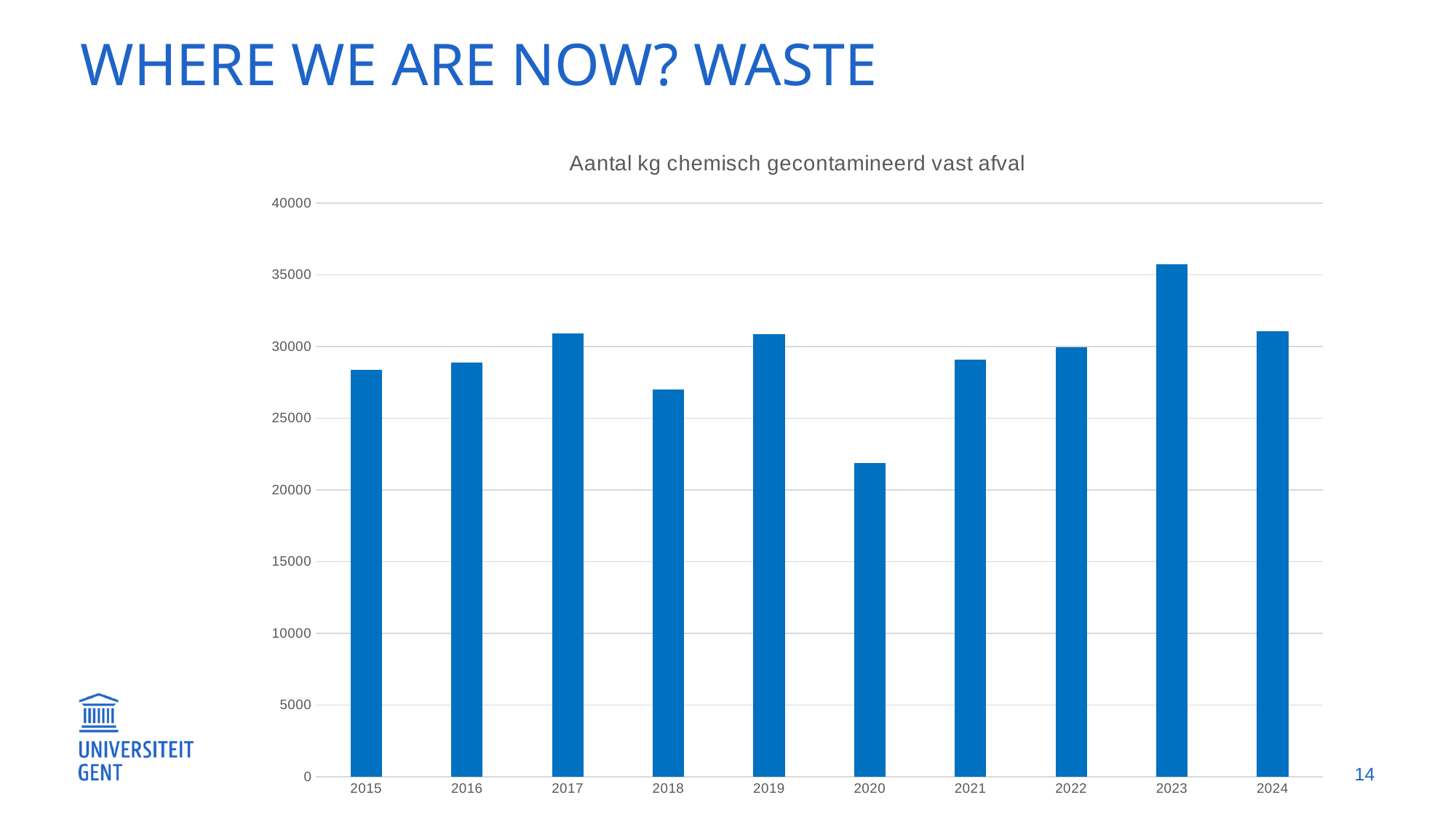
Which year has the larger value, 2018 or 2022? 2022 Which year has the lowest value in the chart? 2020 Is the value for 2015 greater or less than 30000? less What kind of chart is shown on the slide? Bar chart Which year has the highest value in the chart? 2023 Is the value for 2018 greater or less than 25000? greater Do the values rise or fall from 2020 to 2023? rise Is the value for 2023 greater or less than 30000? greater Which year has the larger value, 2020 or 2021? 2021 How many years are shown on the x axis of the chart? 10 What is the title of the chart? Aantal kg chemisch gecontamineerd vast afval